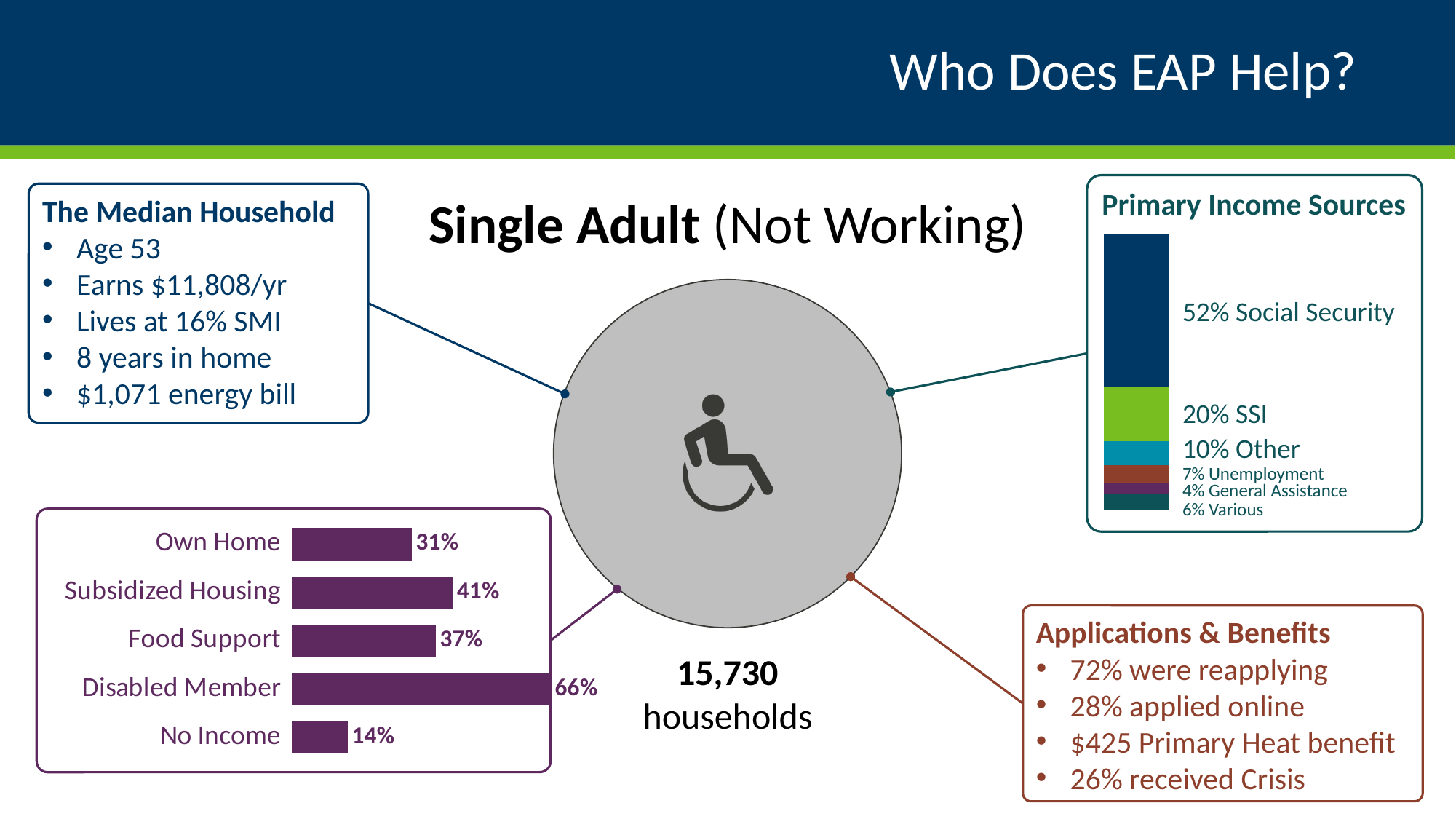
In the bottom-left bar chart, what is the value for No Income? 14% In the Primary Income Sources chart, what share is General Assistance? 4% In the bottom-left bar chart, which is larger, Food Support or Subsidized Housing? Subsidized Housing What kind of chart is the bottom-left chart? Bar chart How many segments does the Primary Income Sources stacked bar have? 6 In the bottom-left bar chart, what is the difference between Disabled Member and Own Home? 35% In the bottom-left bar chart, which category has the highest value? Disabled Member In the Primary Income Sources chart, what share is Social Security? 52% How many categories does the bottom-left bar chart show? 5 In the Primary Income Sources chart, what is the difference between Social Security and SSI? 32% In the bottom-left bar chart, which category has the lowest value? No Income In the bottom-left bar chart, what is the value for Subsidized Housing? 41%